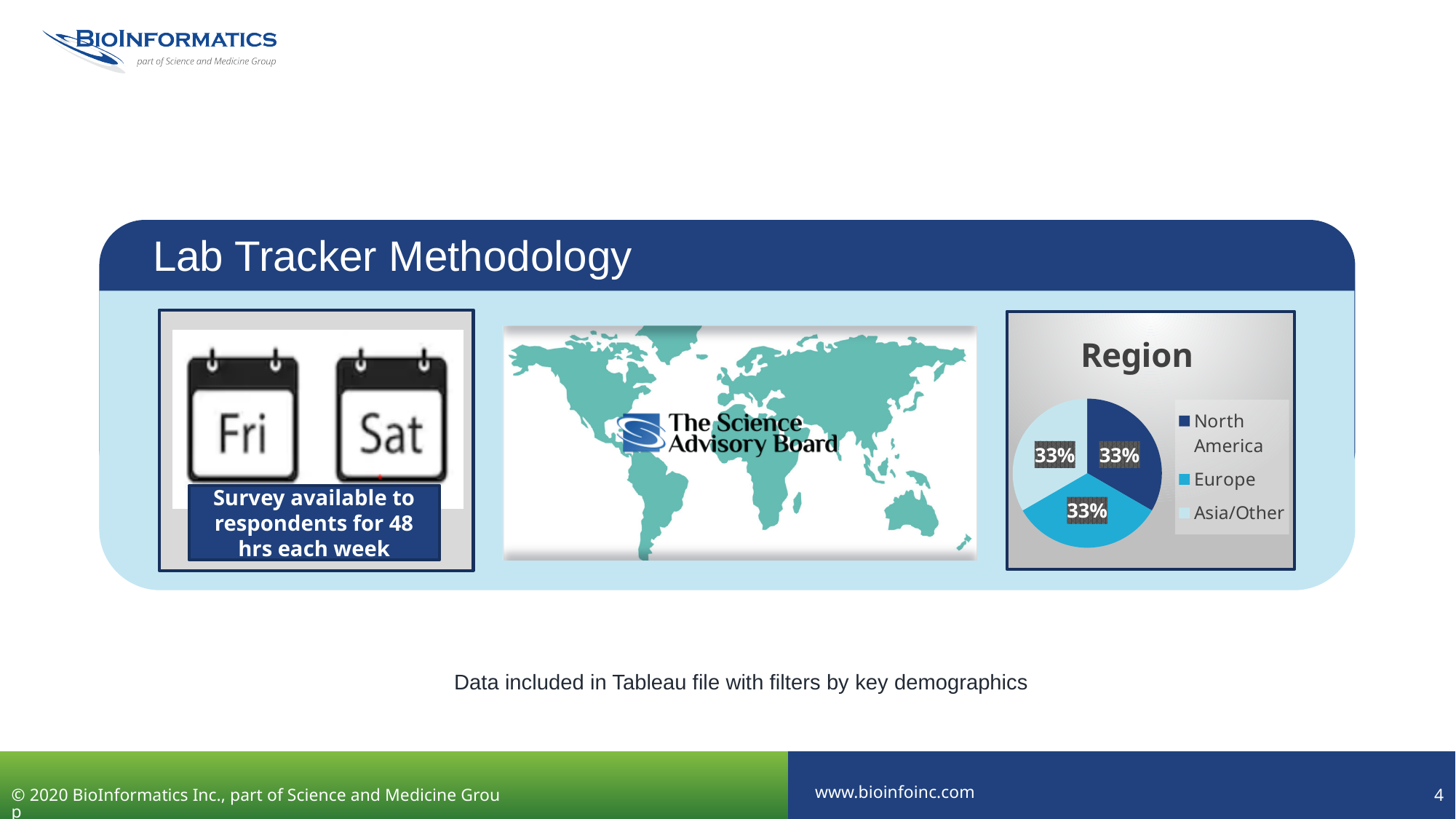
What kind of chart is the "Region" chart? pie chart What share of the pie does Asia/Other have? 33% What is the title of the pie chart? Region Which regions are listed in the legend of the "Region" chart? North America, Europe, Asia/Other Which legend entry is shown in the darkest blue in the "Region" chart? North America How many slices does the "Region" pie chart have? 3 How many entries does the legend of the "Region" chart list? 3 What is the difference between the North America and Europe shares in the "Region" chart? 0% What share of the pie does North America have? 33% What share of the pie does Europe have? 33%